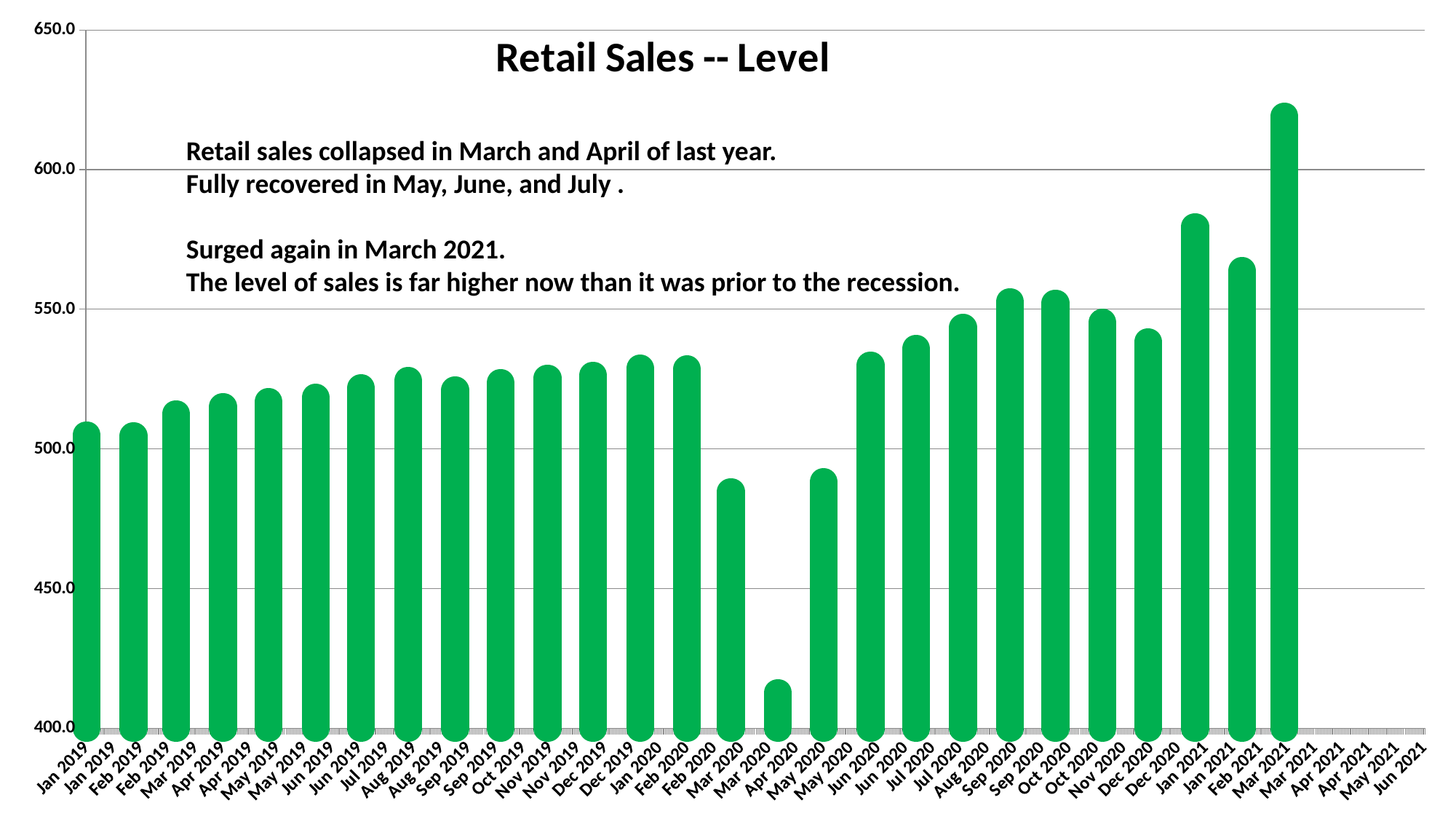
What is the title of the chart? Retail Sales -- Level Which month has the highest retail sales level? Mar 2021 Is the value for Apr 2020 greater or less than 450? less Is the value for Mar 2020 greater or less than 500? less Which month has the lowest retail sales level? Apr 2020 Is the value for Mar 2021 greater or less than 600? greater What colour are the bars in the chart? green Which is larger, the value for Mar 2021 or the value for Jan 2021? Mar 2021 What kind of chart is shown on the slide? bar chart Which is larger, the value for Apr 2020 or the value for May 2020? May 2020